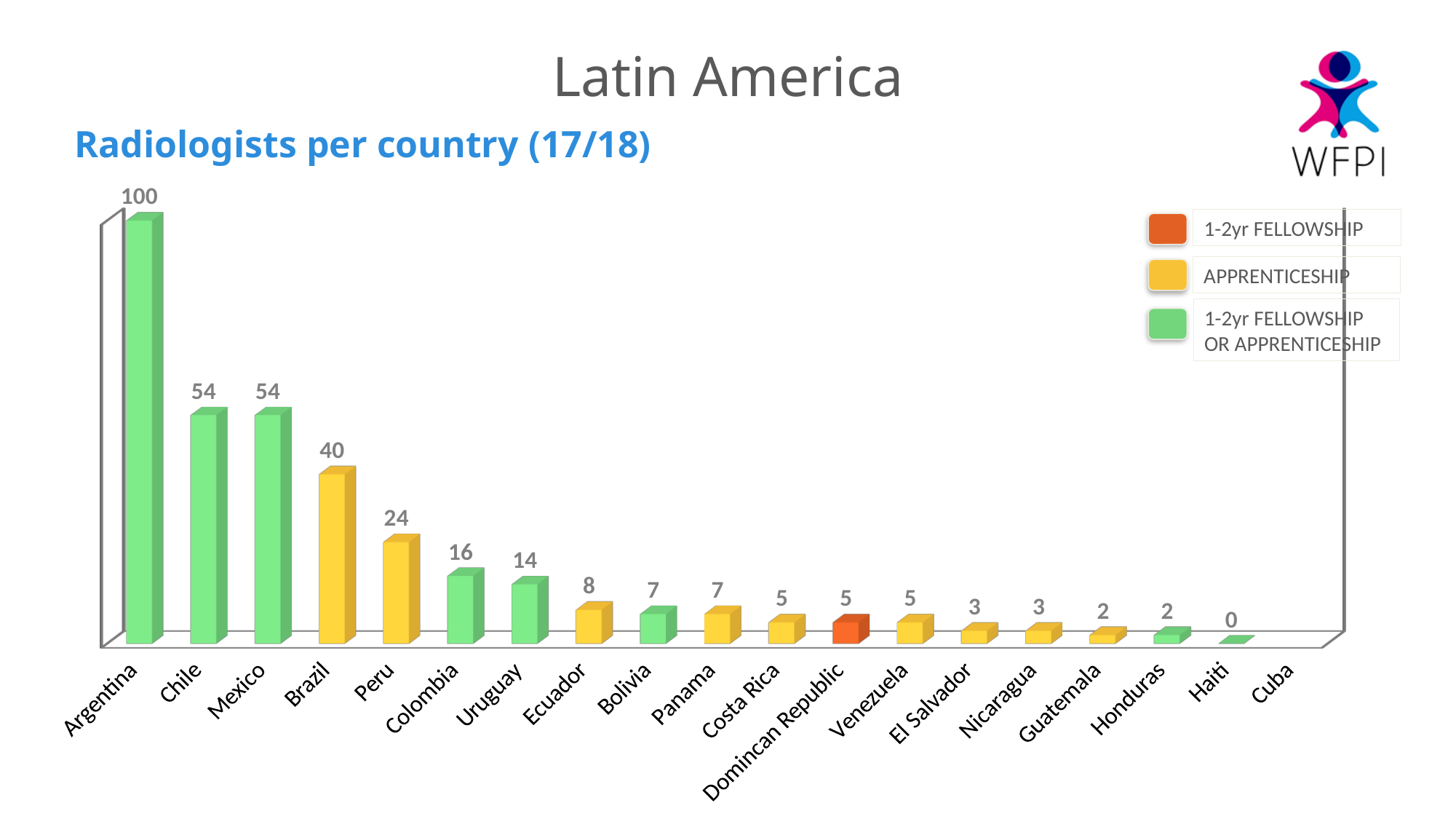
Which country has the highest value? Argentina How many entries does the legend list? 3 What is the value for Brazil? 40 What is the value for Argentina? 100 How many countries are shown on the x axis? 19 What is the difference between the values for Argentina and Chile? 46 Which legend category does the Dominican Republic bar belong to? 1-2yr FELLOWSHIP What is the value for Uruguay? 14 What is the value for Peru? 24 What kind of chart is shown? Bar chart Which has a larger value, Brazil or Peru? Brazil Do the values rise or fall from left to right along the x axis? Fall